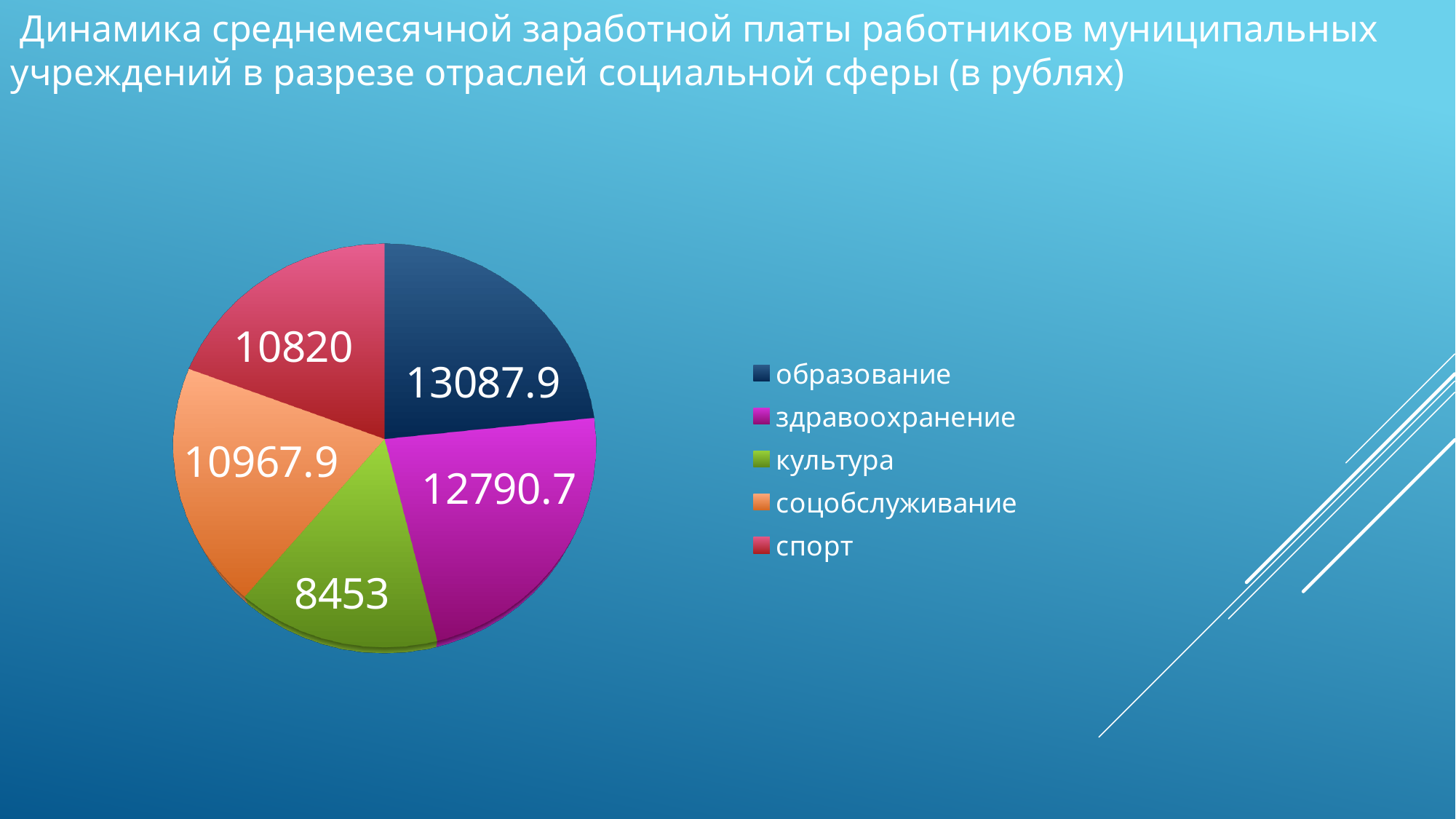
What is the value for соцобслуживание? 10967.9 Which legend entry is shown in green? культура How many categories does the pie chart have? 5 What is the value for культура? 8453 What kind of chart is shown on the slide? pie chart What is the difference between the values for образование and культура? 4634.9 Which category has the lowest value? культура Which category has the highest value? образование Which is larger, the value for соцобслуживание or the value for спорт? соцобслуживание What is the value for образование? 13087.9 What is the difference between the values for образование and здравоохранение? 297.2 What is the value for спорт? 10820